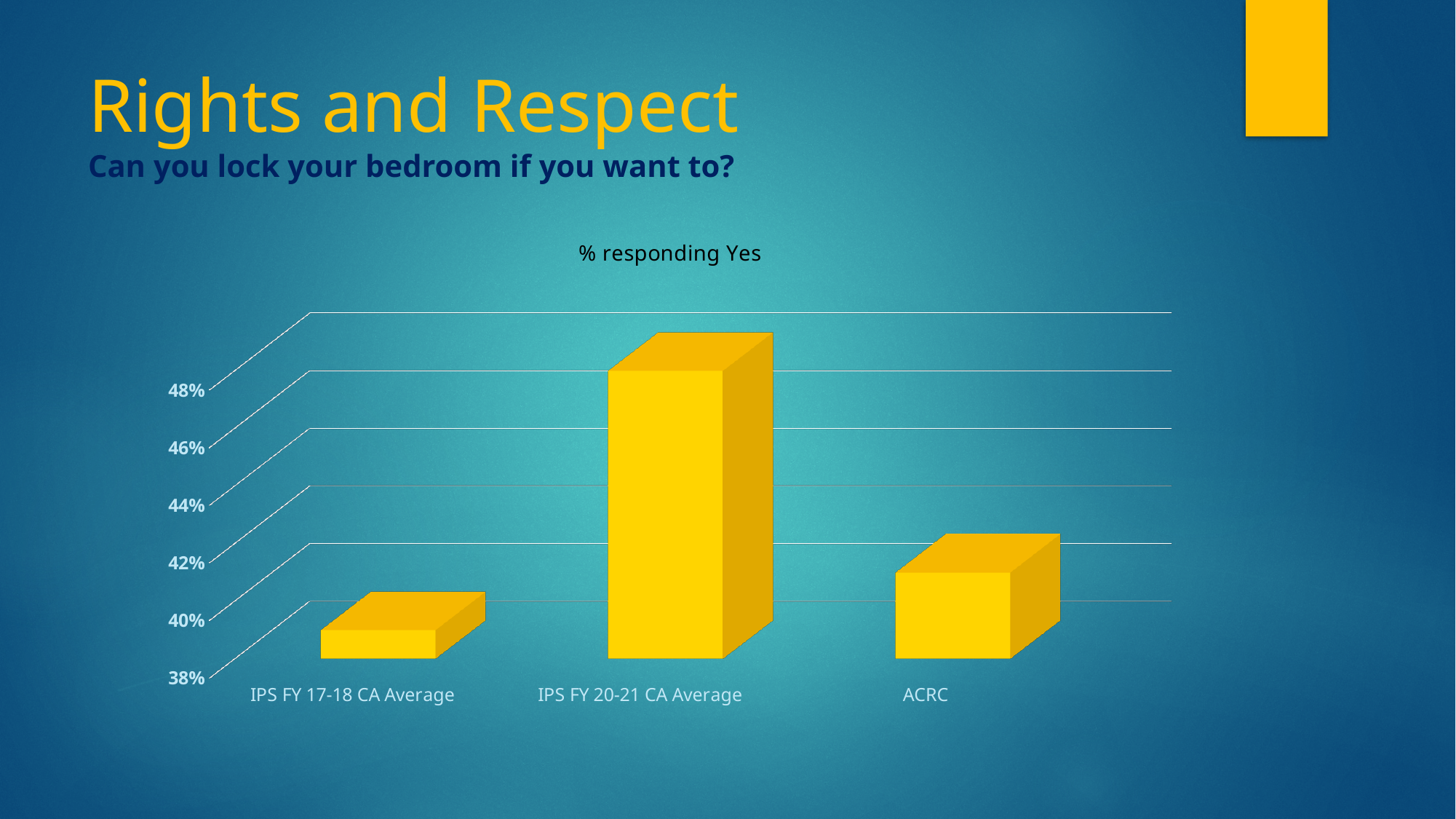
What colour are the bars in the chart? yellow Is the value for IPS FY 20-21 CA Average greater or less than 46%? greater Is the value for ACRC greater or less than 40%? greater Is the value for ACRC greater or less than 44%? less Which is larger, the value for ACRC or the value for IPS FY 17-18 CA Average? ACRC What is the title of the chart? % responding Yes Which category has the lowest value? IPS FY 17-18 CA Average Which is larger, the value for IPS FY 20-21 CA Average or the value for ACRC? IPS FY 20-21 CA Average What kind of chart is shown on the slide? bar chart How many categories are plotted in the chart? 3 Which category has the highest value? IPS FY 20-21 CA Average